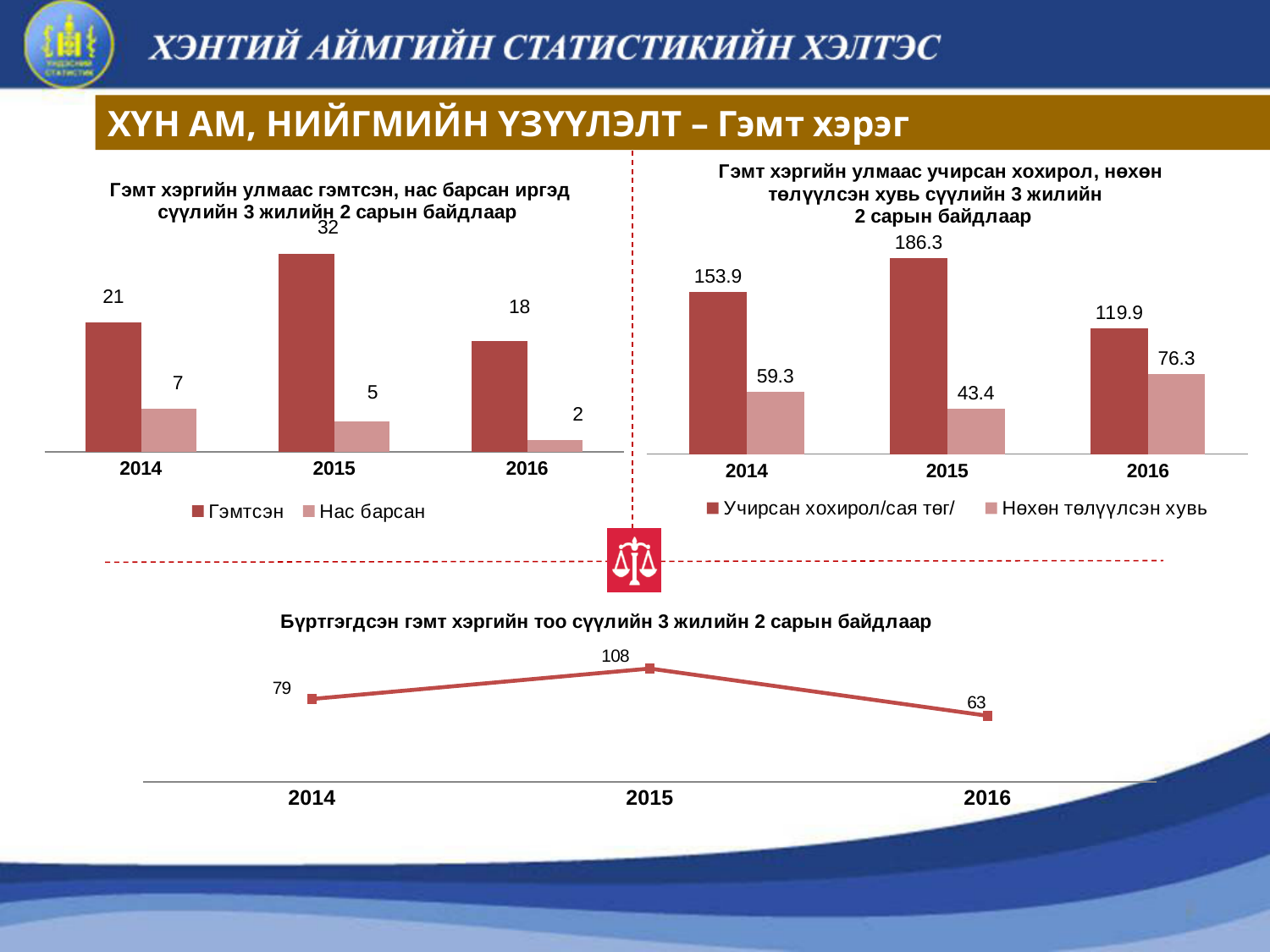
In the top-left chart, what is the value for Гэмтсэн in 2015? 32 In the bottom chart, how many data points are plotted? 3 In the top-left chart, what is the value for Нас барсан in 2016? 2 In the top-right chart, what is the value for Нөхөн төлүүлсэн хувь in 2015? 43.4 In the top-right chart, which year has the lowest value for Нөхөн төлүүлсэн хувь? 2015 In the top-right chart, how many series does the legend list? 2 In the top-left chart, which year has the highest value for Гэмтсэн? 2015 In the bottom chart, which year has the lowest value? 2016 In the bottom chart, what is the value for 2015? 108 What kind of chart is the bottom chart? Line chart In the top-left chart, what is the difference between Гэмтсэн and Нас барсан in 2014? 14 In the top-right chart, what is the value for Учирсан хохирол/сая төг/ in 2016? 119.9